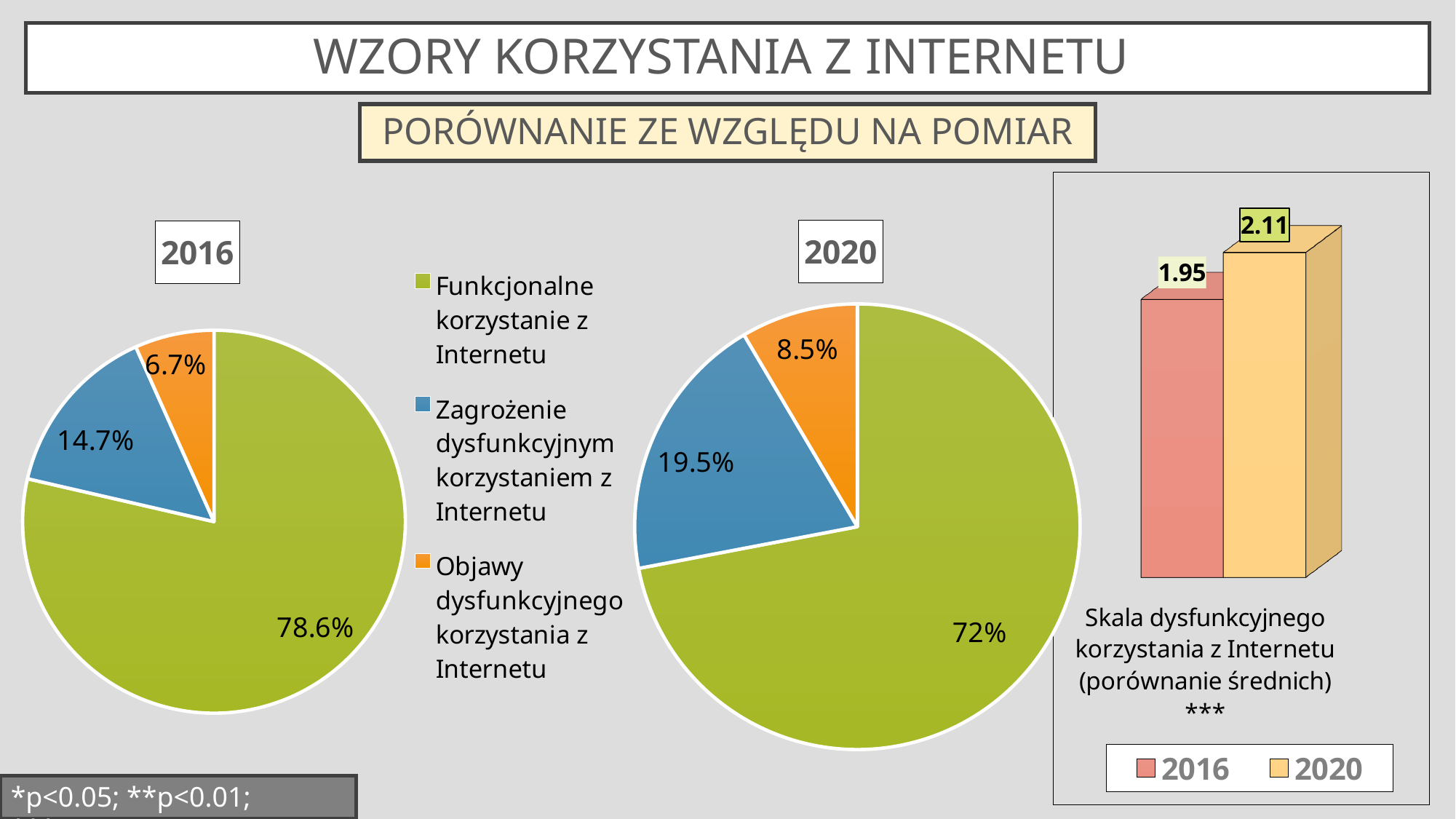
How many series does the legend of the bar chart on the right list? 2 In the 2016 pie chart, what share is shown for 'Objawy dysfunkcyjnego korzystania z Internetu'? 6.7% By how many percentage points did the share of 'Zagrożenie dysfunkcyjnym korzystaniem z Internetu' change between the 2016 and 2020 pie charts? 4.8 percentage points In the 2016 pie chart, what share is shown for 'Funkcjonalne korzystanie z Internetu'? 78.6% In the bar chart on the right ('Skala dysfunkcyjnego korzystania z Internetu'), what is the value for 2020? 2.11 In the bar chart on the right ('Skala dysfunkcyjnego korzystania z Internetu'), what is the difference between the 2020 and 2016 values? 0.16 In the 2016 pie chart, which category has the smallest slice? Objawy dysfunkcyjnego korzystania z Internetu How many slices does the 2020 pie chart have? 3 In the 2020 pie chart, what share is shown for 'Zagrożenie dysfunkcyjnym korzystaniem z Internetu'? 19.5% What type of chart is the chart on the right titled 'Skala dysfunkcyjnego korzystania z Internetu'? Bar chart In the 2020 pie chart, which category has the largest slice? Funkcjonalne korzystanie z Internetu Is the share of 'Objawy dysfunkcyjnego korzystania z Internetu' larger in the 2016 pie chart or the 2020 pie chart? 2020